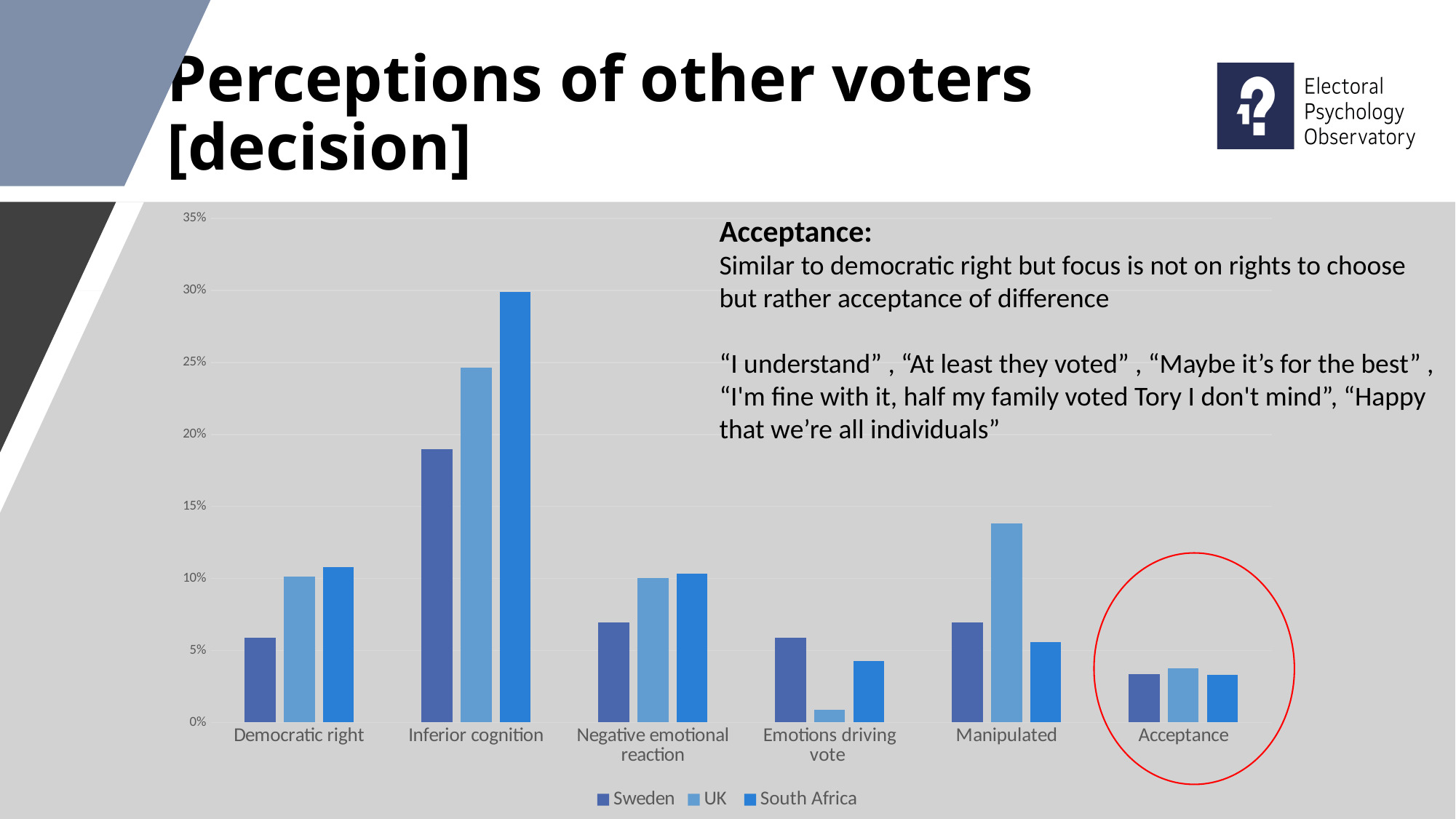
Is the South Africa value for Inferior cognition greater or less than 25%? greater In the Emotions driving vote category, which is larger: the Sweden value or the UK value? Sweden Which series has the highest value in the Inferior cognition category? South Africa Which category has the highest value for South Africa? Inferior cognition How many series does the chart's legend list? 3 What kind of chart is shown on the slide? bar chart In the Manipulated category, which is larger: the UK value or the South Africa value? UK How many categories are shown along the x axis of the chart? 6 Is the Sweden value for Democratic right greater or less than 10%? less Is the UK value for Manipulated greater or less than 10%? greater Which category has the lowest value for the UK? Emotions driving vote Which category on the chart is circled in red? Acceptance